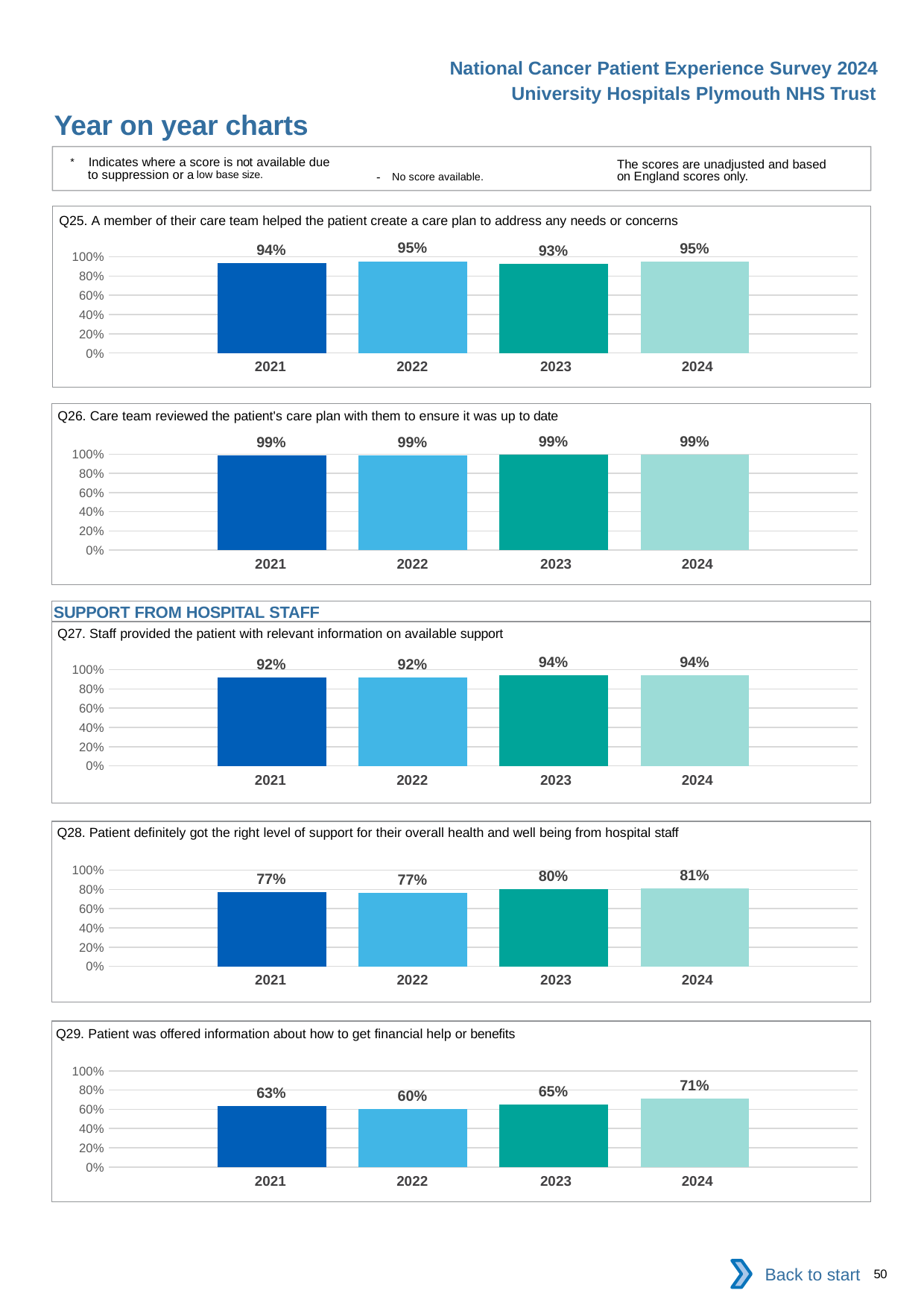
In the Q28 chart, which is larger, the value for 2023 or the value for 2021? 2023 How many years are shown in the Q27 chart? 4 In the Q27 chart, what is the value for 2021? 92% In the Q25 chart, what is the value for 2023? 93% In the Q26 chart, what is the value for 2024? 99% In the Q29 chart, what is the difference between the 2024 value and the 2021 value? 8% In the Q29 chart, is the value for 2022 greater or less than 80%? less What kind of chart is the Q25 chart? bar chart In the Q28 chart, which year has the highest value? 2024 How many charts are on the slide? 5 In the Q29 chart, do the values rise or fall from 2022 to 2024? rise In the Q29 chart, which year has the lowest value? 2022